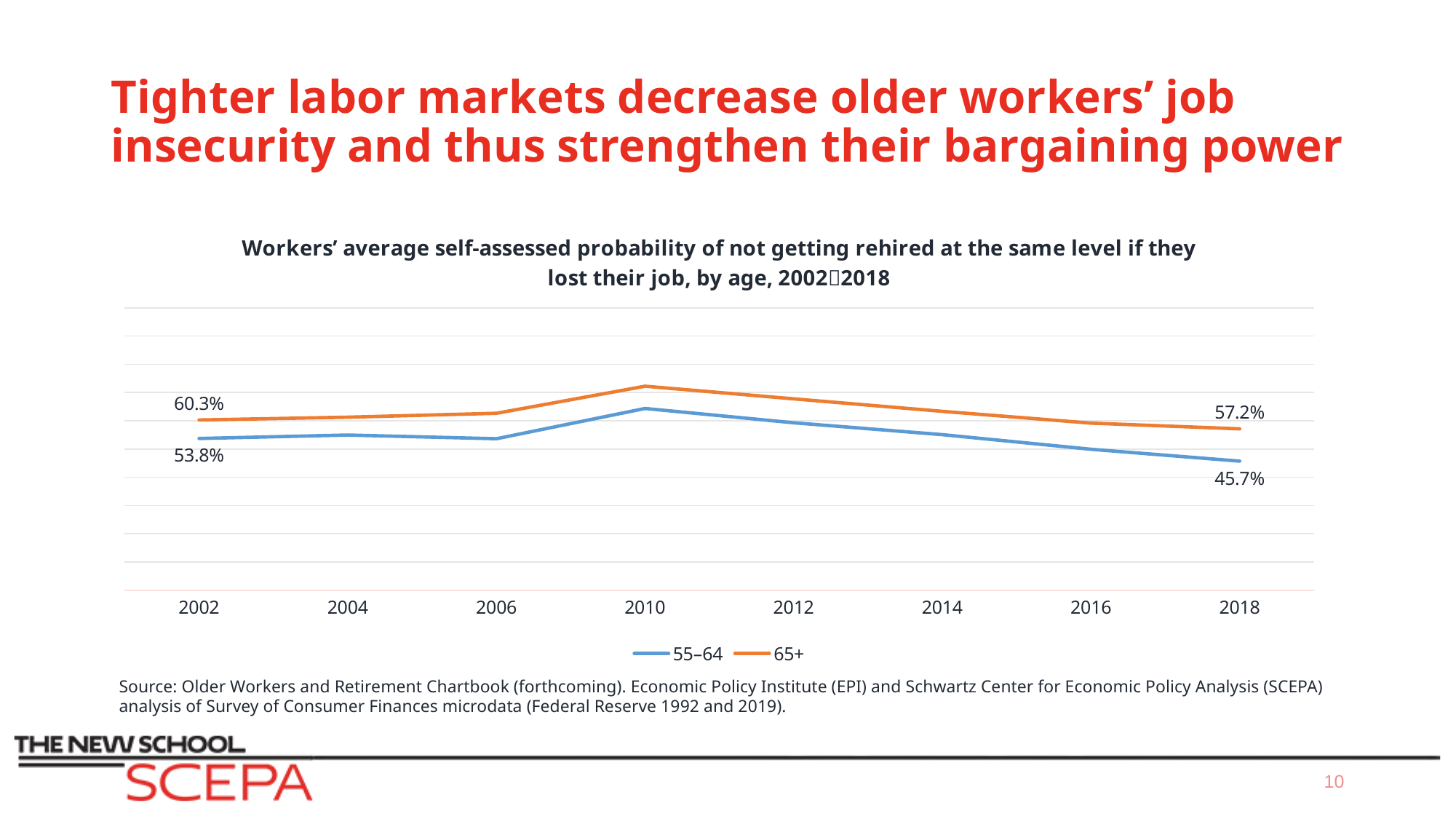
What is the value for the 65+ series in 2018? 57.2% What is the value for the 65+ series in 2002? 60.3% In which year does the 65+ series reach its highest point? 2010 How many series does the legend list? 2 What kind of chart is shown on the slide? Line chart By how many percentage points does the 65+ value exceed the 55–64 value in 2018? 11.5 percentage points By how many percentage points did the 55–64 value fall from 2002 to 2018? 8.1 percentage points Which series has the higher value in 2018, 55–64 or 65+? 65+ How many years are plotted along the x axis? 8 What is the value for the 55–64 series in 2002? 53.8% By how many percentage points does the 65+ value exceed the 55–64 value in 2002? 6.5 percentage points What is the value for the 55–64 series in 2018? 45.7%